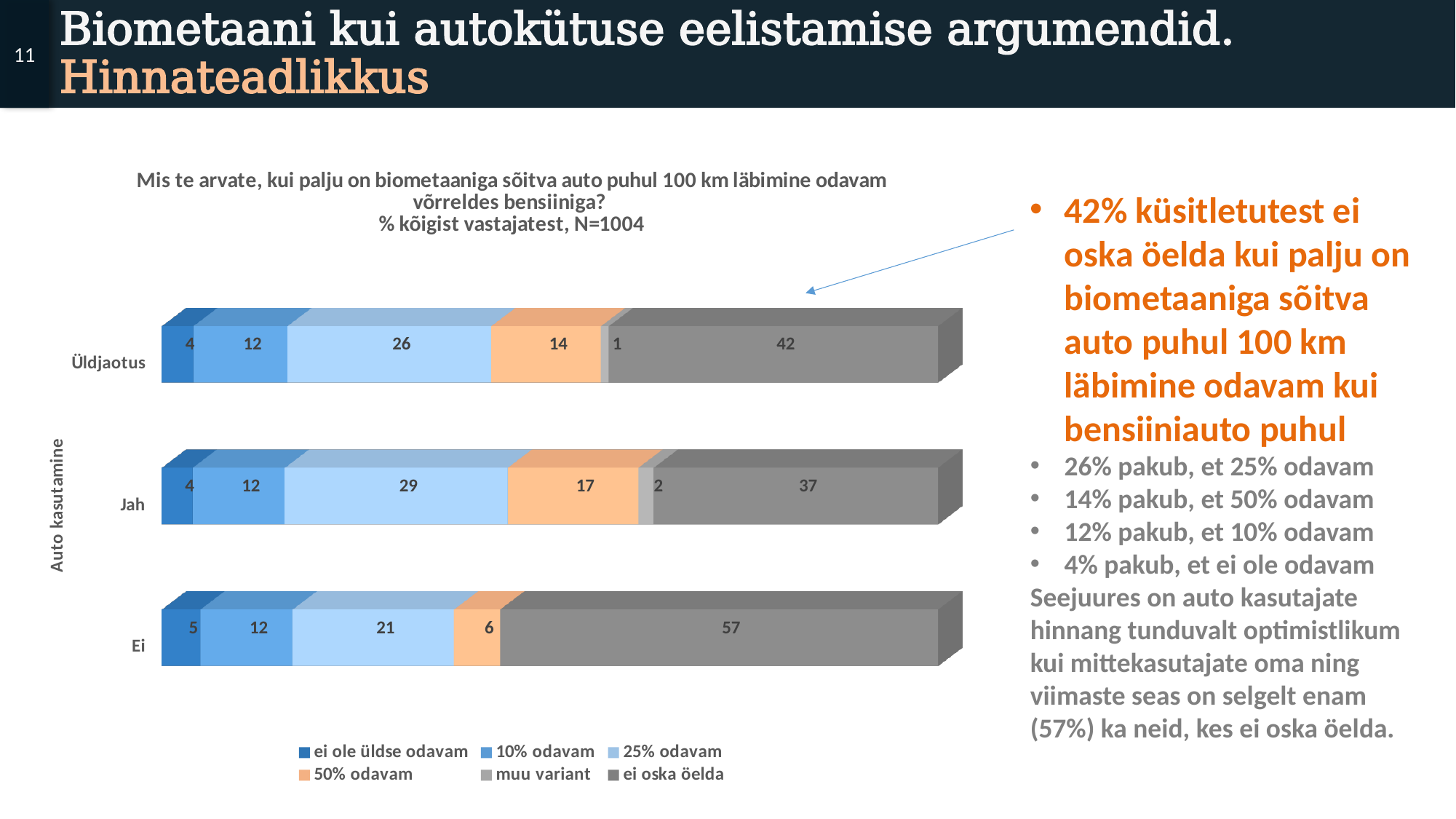
What type of chart is shown on the slide? stacked bar chart How many series does the legend list? 6 How many categories are shown on the vertical axis? 3 Which category has the highest value for 'ei oska öelda'? Ei What is the value of 'ei oska öelda' for Üldjaotus? 42 What is the value of '50% odavam' for Ei? 6 Which category has the lowest value for '25% odavam'? Ei What is the difference between the 'ei oska öelda' values for Ei and Jah? 20 What is the value of 'ei oska öelda' for Ei? 57 What is the value of '25% odavam' for Jah? 29 What is the total of the stacked bar for Jah? 101 Which is larger: the '50% odavam' value for Jah or for Üldjaotus? Jah